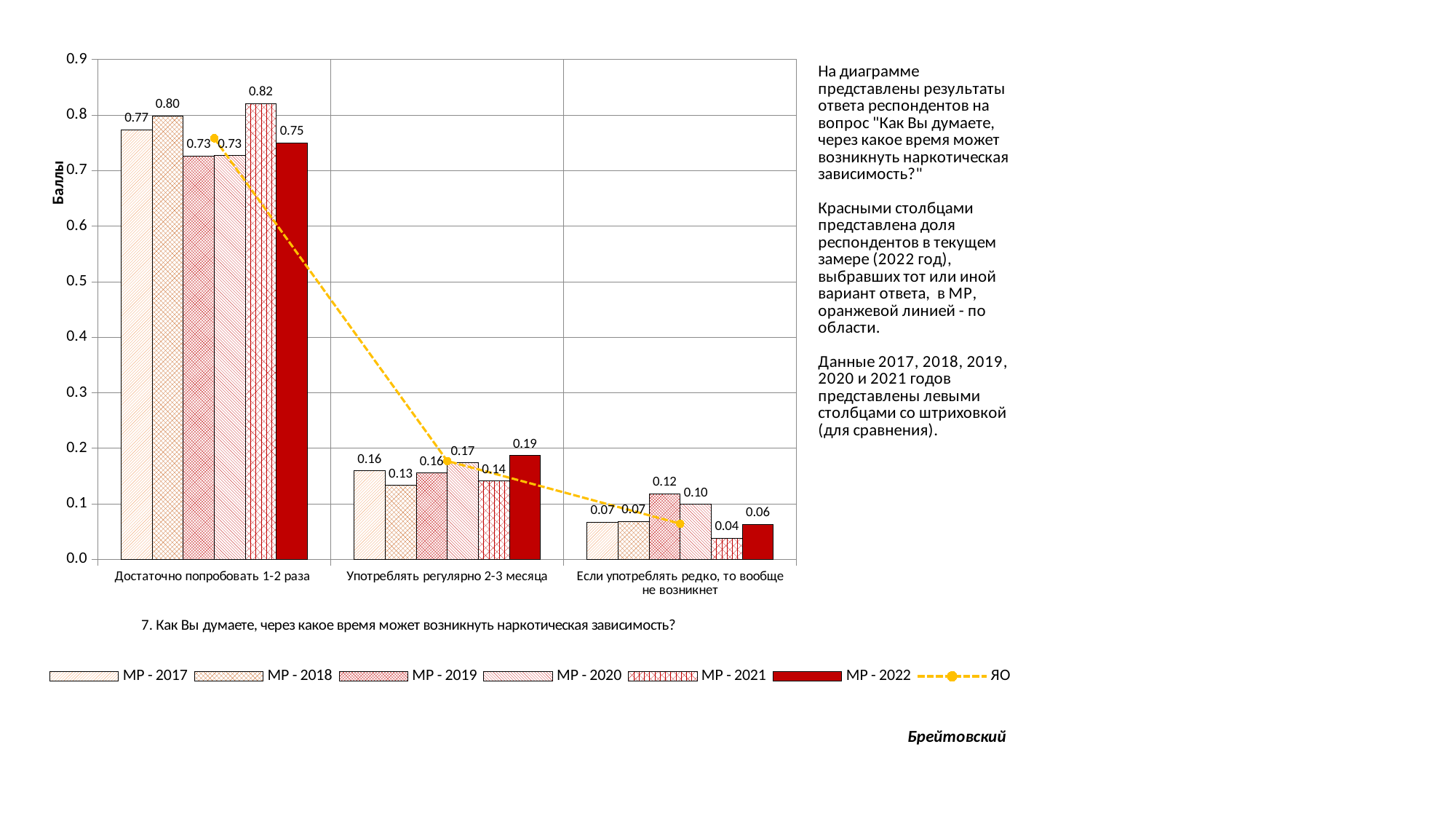
For the МР - 2022 series, which category has the lowest value? Если употреблять редко, то вообще не возникнет What is the value of МР - 2021 for "Если употреблять редко, то вообще не возникнет"? 0.04 For "Употреблять регулярно 2-3 месяца", what is the difference between МР - 2022 and МР - 2021? 0.05 Is the ЯО line value for "Достаточно попробовать 1-2 раза" greater or less than 0.5? greater Do the МР - 2022 values rise or fall from left to right across the categories? fall What is the value of МР - 2018 for "Употреблять регулярно 2-3 месяца"? 0.13 How many categories are shown on the x axis? 3 For "Если употреблять редко, то вообще не возникнет", which is larger: МР - 2019 or МР - 2020? МР - 2019 What kind of chart is this? bar chart with a line How many series does the legend list? 7 Which series has the highest value for "Достаточно попробовать 1-2 раза"? МР - 2021 What is the value of МР - 2022 for "Достаточно попробовать 1-2 раза"? 0.75